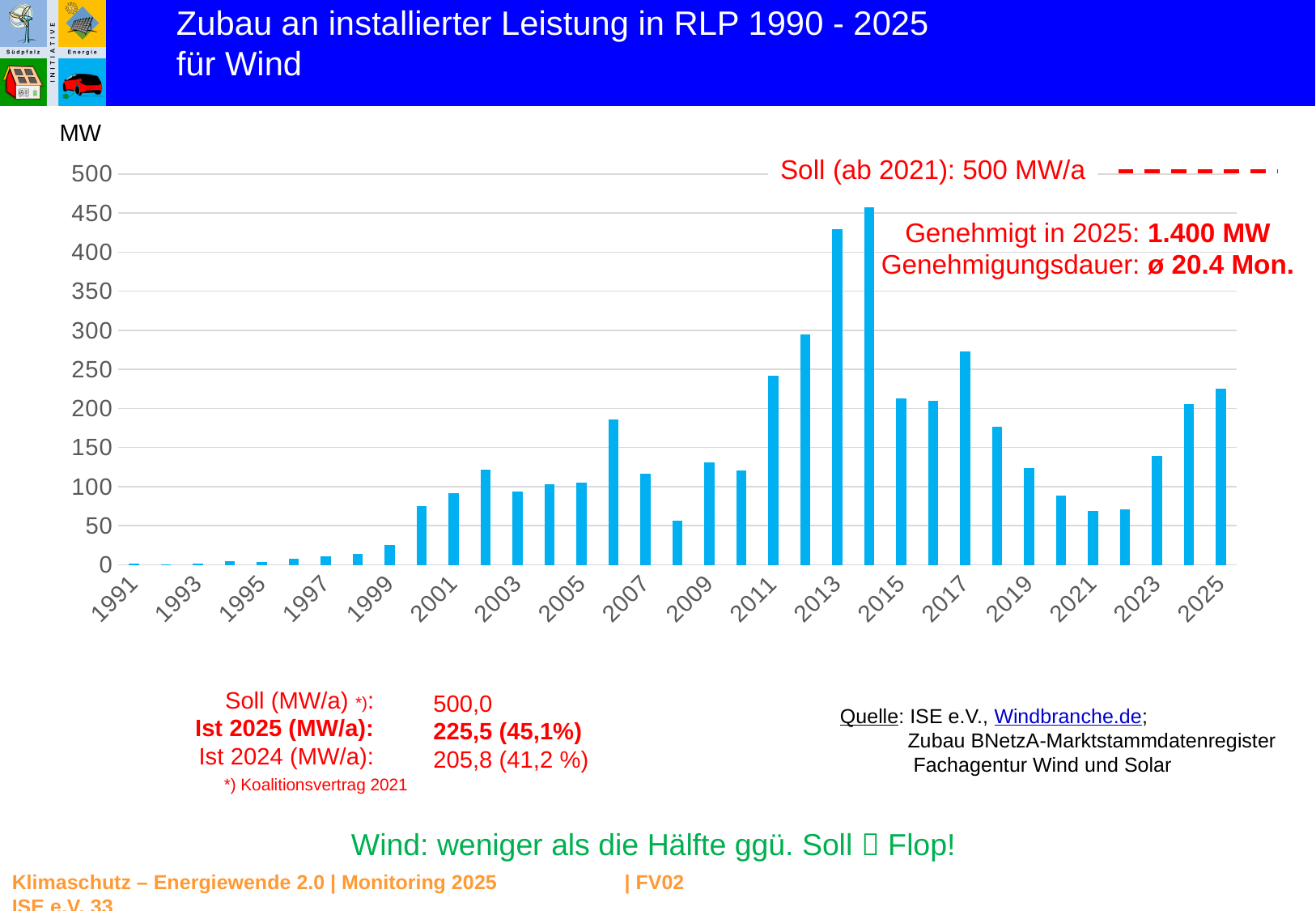
Which is larger, the value for 2013 or the value for 2017? 2013 What unit is shown on the y axis? MW Is the value for 2017 greater or less than 250? greater What target value (Soll) does the dashed red line represent? 500 MW/a According to the slide, what is the Ist 2025 value in MW/a? 225,5 Is the value for 2007 greater or less than 150? less According to the slide, what is the Ist 2024 value in MW/a? 205,8 Which year has the highest bar in the chart? 2014 Is the value for 2023 greater or less than 150? less Do the values rise or fall from 2014 to 2021? fall What kind of chart is shown on the slide? bar chart What is the difference between the Ist 2025 and Ist 2024 values in MW/a? 19,7